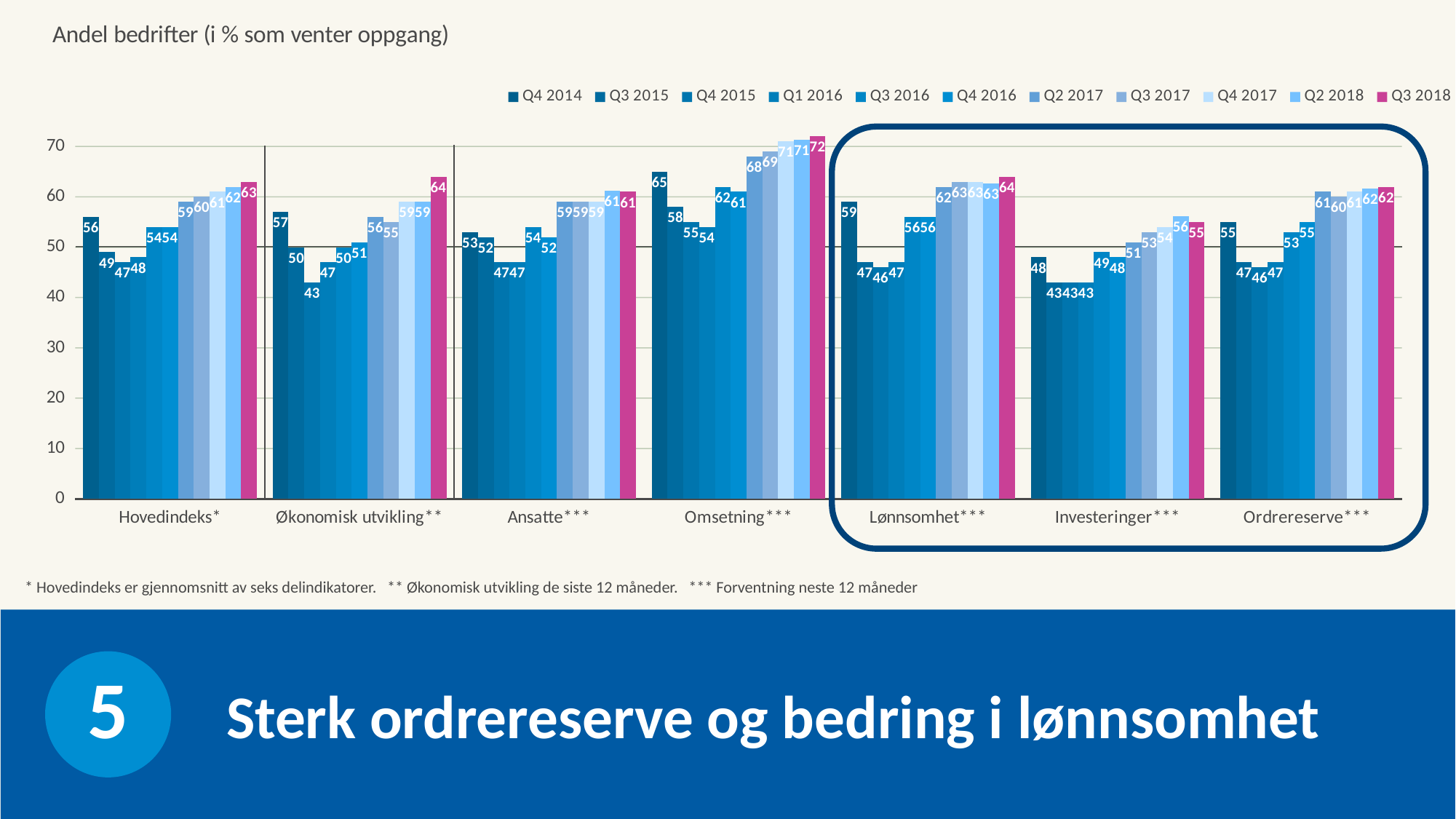
What is the Q4 2014 value for Hovedindeks*? 56 What kind of chart is shown? Bar chart What is the Q3 2018 value for Investeringer***? 55 What is the Q3 2018 value for Omsetning***? 72 What is the Q4 2015 value for Økonomisk utvikling**? 43 How many series does the legend list? 11 How many categories are shown on the x axis? 7 What is the difference between the Q3 2018 values for Omsetning*** and Investeringer***? 17 Which is larger for Q3 2018: Hovedindeks* or Lønnsomhet***? Lønnsomhet*** Do the values for Omsetning*** rise or fall from Q2 2017 to Q3 2018? Rise Which category has the highest Q3 2018 value? Omsetning*** Which category has the lowest Q3 2018 value? Investeringer***